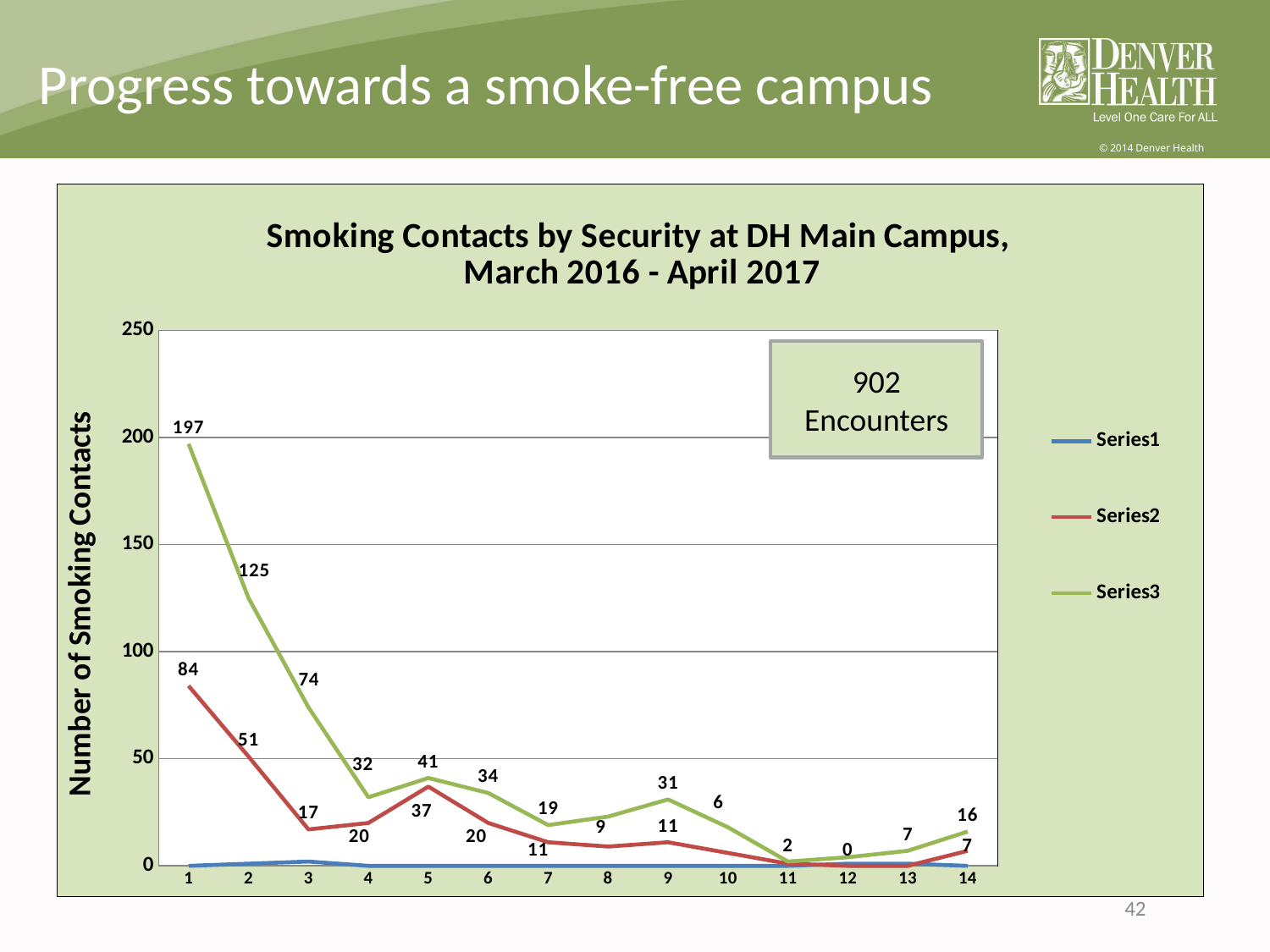
What is the value of Series2 at point 1? 84 What is the value of Series2 at point 5? 37 What is the value of Series3 at point 14? 16 What kind of chart is shown on the slide? Line chart At which x-axis point does Series3 reach its highest value? 1 Which is larger at point 3, Series3 or Series2? Series3 How many points are there along the x axis? 14 How many series does the legend list? 3 Does Series3 generally rise or fall from point 1 to point 14? Fall What is the value of Series3 at point 1? 197 Is the value of Series3 at point 8 greater or less than 50? less What is the difference between the Series3 values at point 1 and point 2? 72